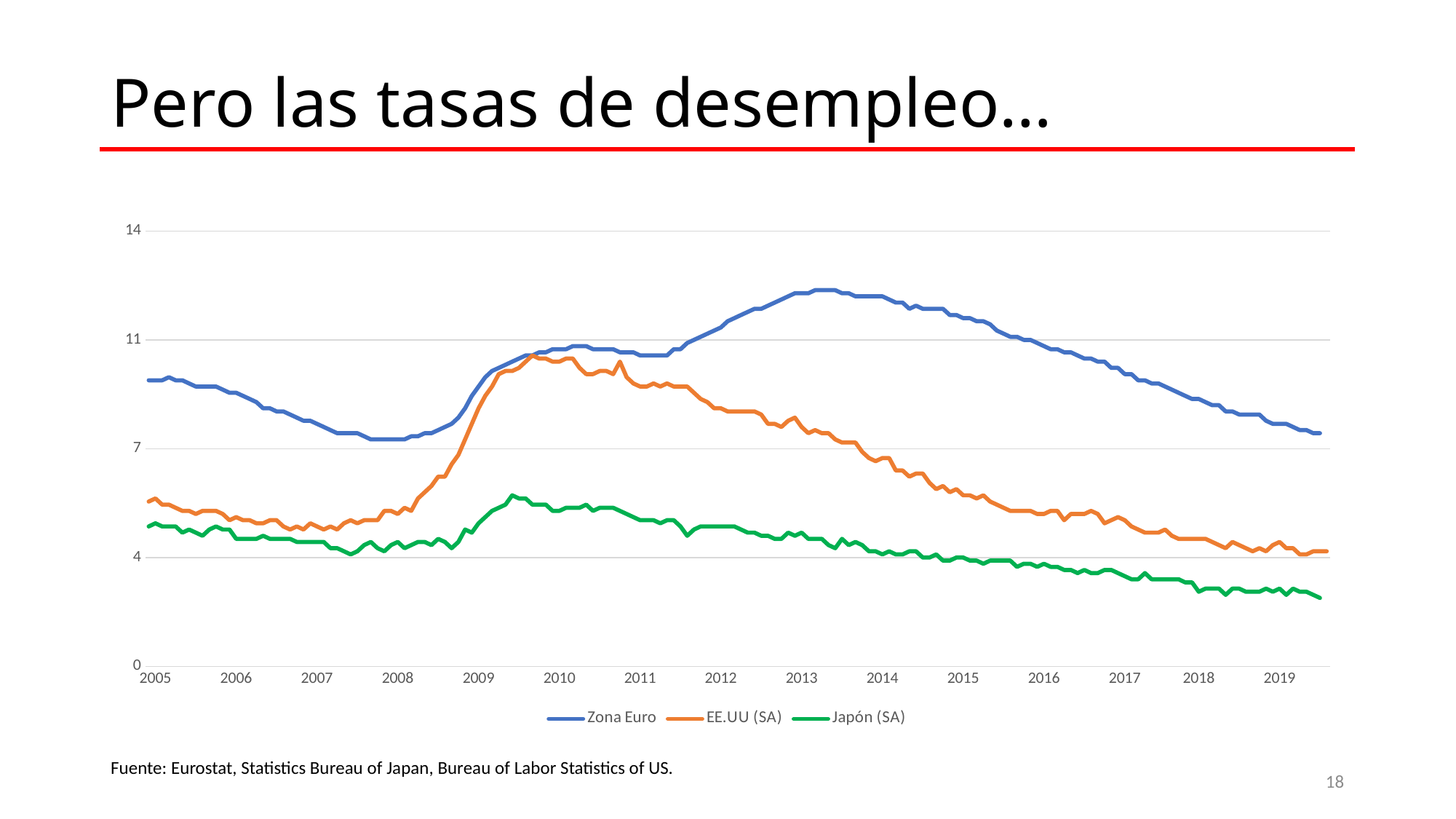
Which series has the lowest value in 2019? Japón (SA) Is the value for EE.UU (SA) in 2005 greater or less than 7? less What kind of chart is shown on the slide? line chart Does the Zona Euro series rise or fall between 2013 and 2019? fall What colour is the line for Zona Euro? blue Is the value for Zona Euro in 2013 greater or less than 11? greater Which series has the highest value in 2013? Zona Euro Is the value for EE.UU (SA) in 2010 greater or less than 7? greater In 2019, which is larger: the value for Zona Euro or the value for EE.UU (SA)? Zona Euro What are the three series named in the legend? Zona Euro, EE.UU (SA), Japón (SA) How many series does the legend list? 3